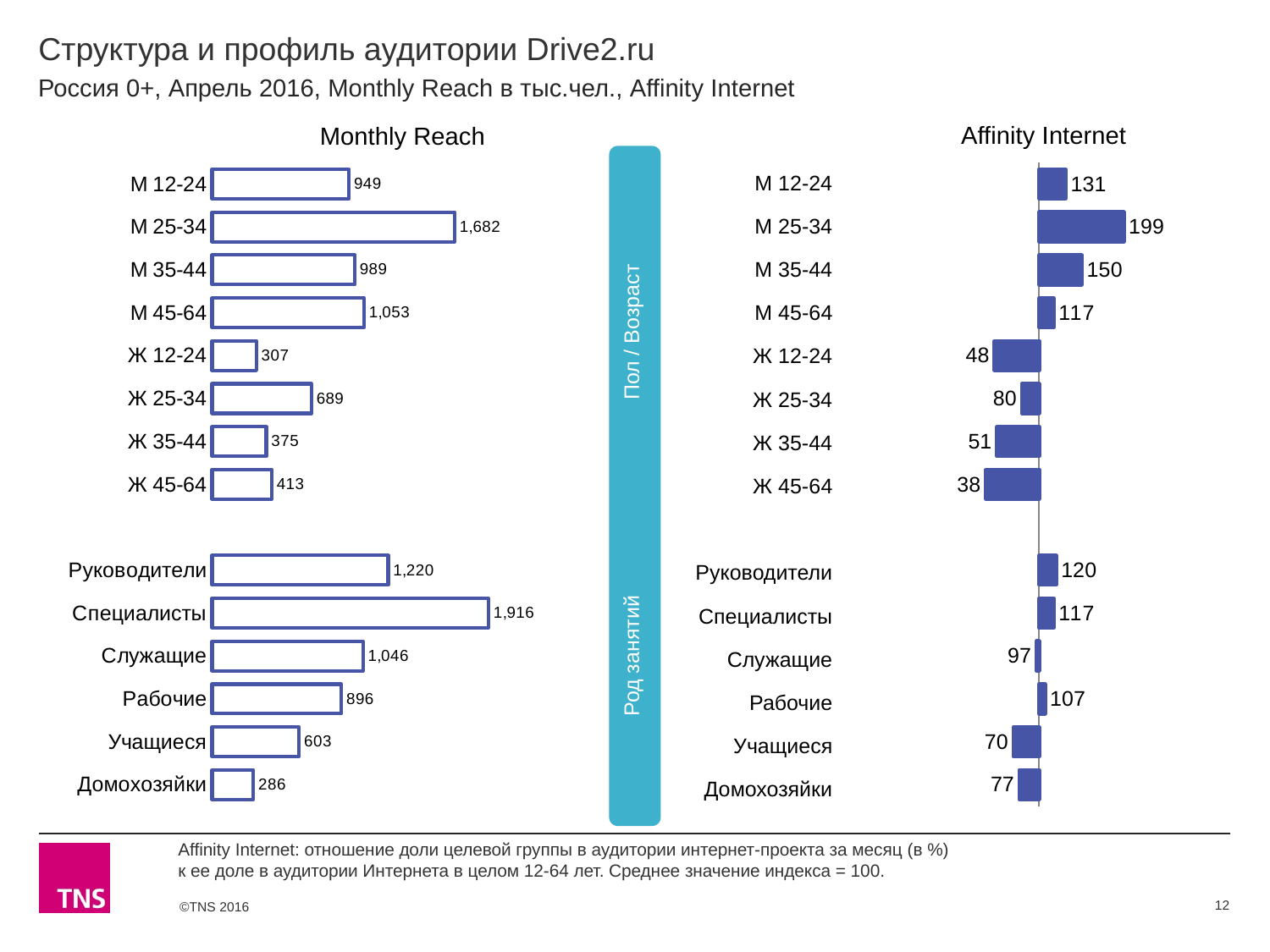
In the Affinity Internet chart, what is the value for М 35-44? 150 In the Monthly Reach chart, what is the difference between Руководители and Рабочие? 324 In the Monthly Reach chart, which is larger: Ж 25-34 or Ж 45-64? Ж 25-34 In the Monthly Reach chart, what is the value for М 25-34? 1,682 In the Monthly Reach chart, which category has the lowest value? Домохозяйки In the Affinity Internet chart, which category has the highest value? М 25-34 In the Monthly Reach chart, which category has the highest value? Специалисты In the Affinity Internet chart, which category has the lowest value? Ж 45-64 How many categories are shown in the Monthly Reach chart? 14 What type of chart is the Affinity Internet chart? Bar chart In the Affinity Internet chart, which is larger: Служащие or Рабочие? Рабочие In the Affinity Internet chart, what is the difference between Руководители and Учащиеся? 50